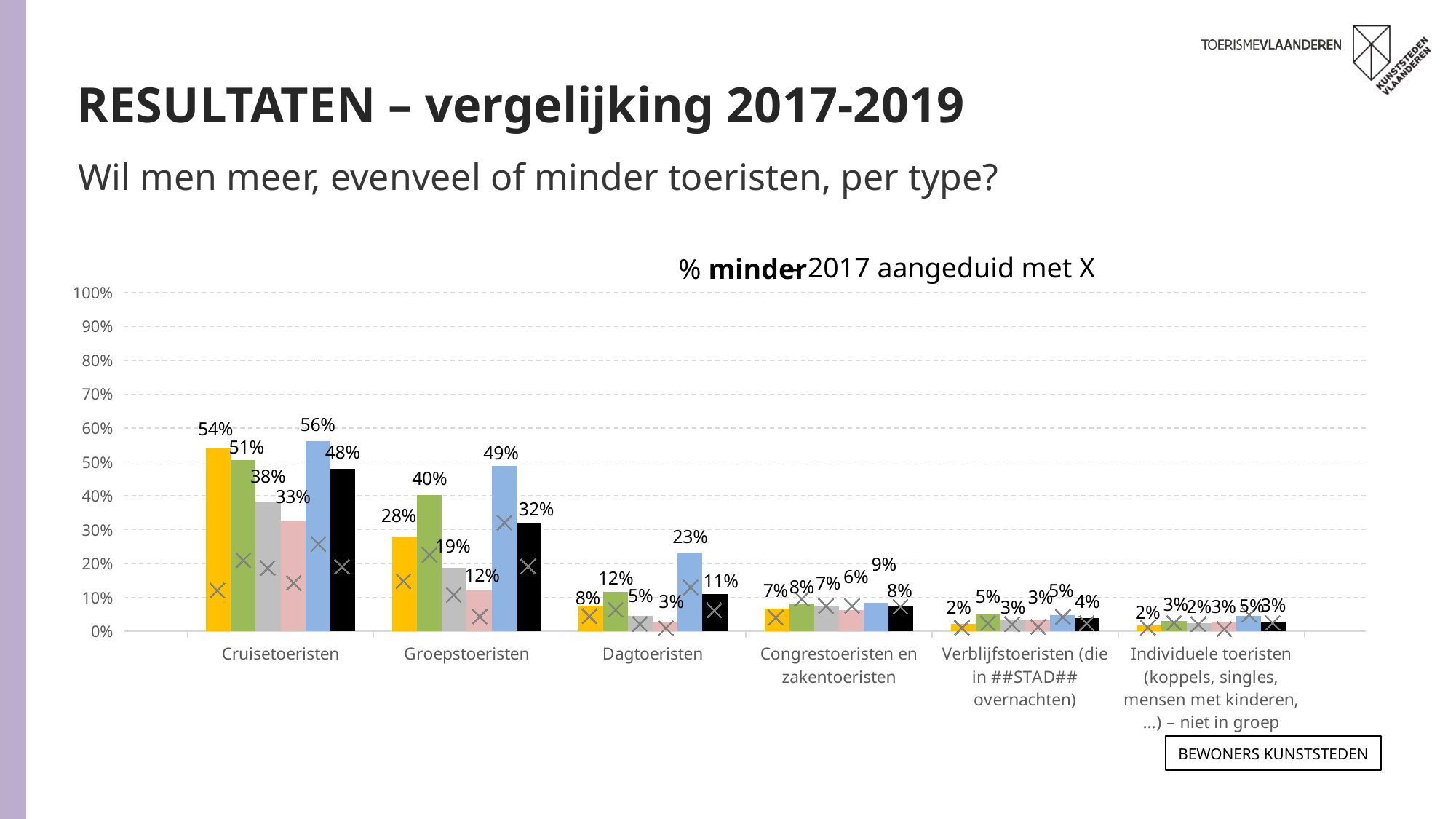
What is the value of the blue bar for Dagtoeristen? 23% What is the value of the black bar for Groepstoeristen? 32% What kind of chart is shown on the slide? bar chart Which category has the highest blue bar? Cruisetoeristen What is the difference between the blue bar and the pink bar for Groepstoeristen? 37% How many tourist-type categories are shown on the x axis? 6 According to the text above the chart, what symbol marks the 2017 '% minder' values? X Is the value of the green bar for Groepstoeristen greater or less than 30%? greater What is the value of the blue bar for Cruisetoeristen? 56% What is the value of the yellow bar for Groepstoeristen? 28% Which is larger for Cruisetoeristen, the yellow bar or the green bar? the yellow bar What is the difference between the yellow bar for Cruisetoeristen and the yellow bar for Groepstoeristen? 26%